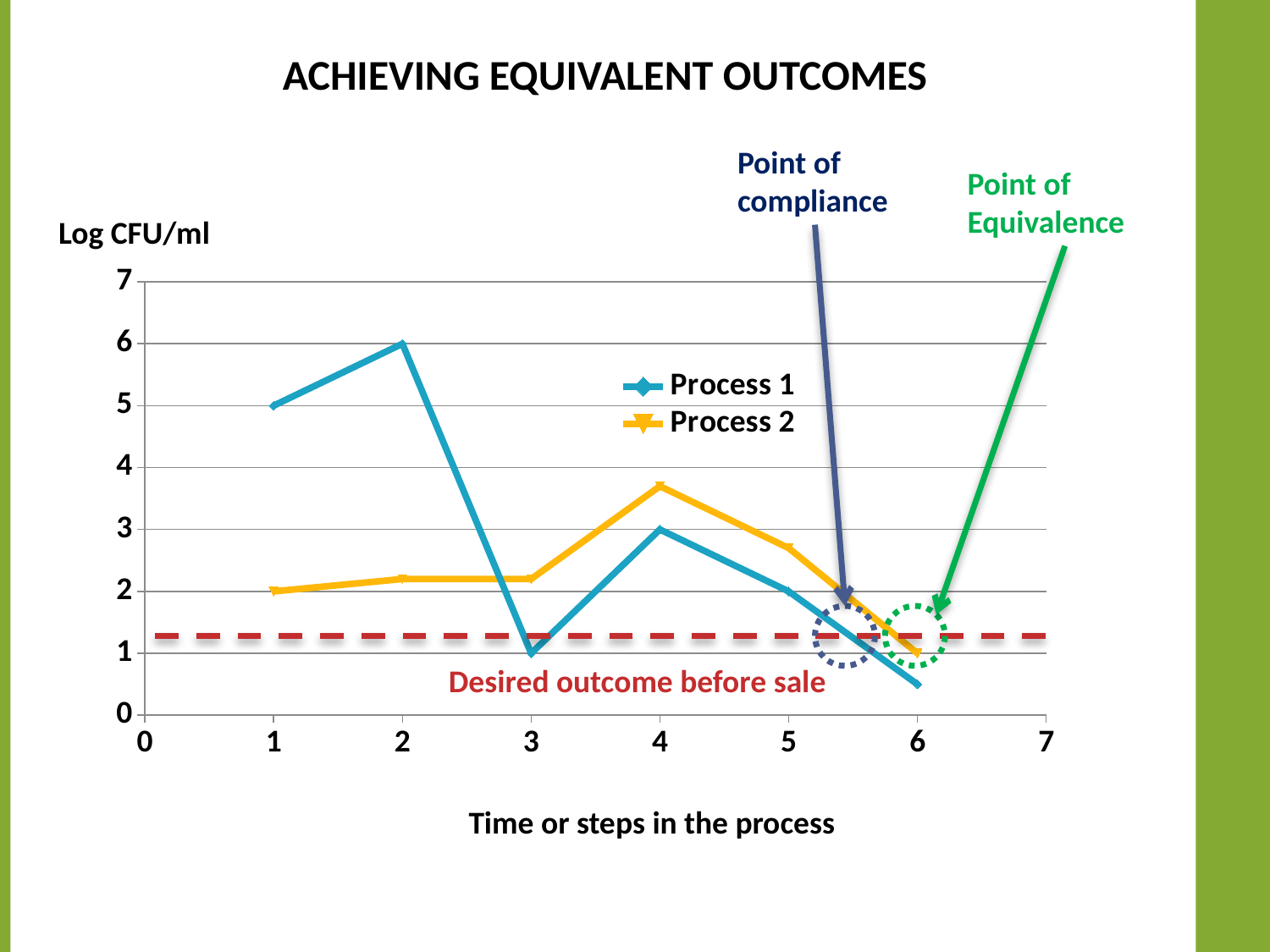
What is the Log CFU/ml value for Process 2 at step 1? 2 At which step does Process 1 reach its highest value? 2 What is the label of the x axis? Time or steps in the process What kind of chart is shown on the slide? line chart What is the difference between Process 1 at step 2 and Process 1 at step 3? 5 At step 1, which series has the higher value, Process 1 or Process 2? Process 1 At which step does Process 2 reach its highest value? 4 Is the value for Process 1 at step 6 greater or less than 1? less How many series does the legend list? 2 Is the value for Process 2 at step 4 greater or less than 3? greater What is the Log CFU/ml value for Process 1 at step 2? 6 What is the Log CFU/ml value for Process 1 at step 3? 1